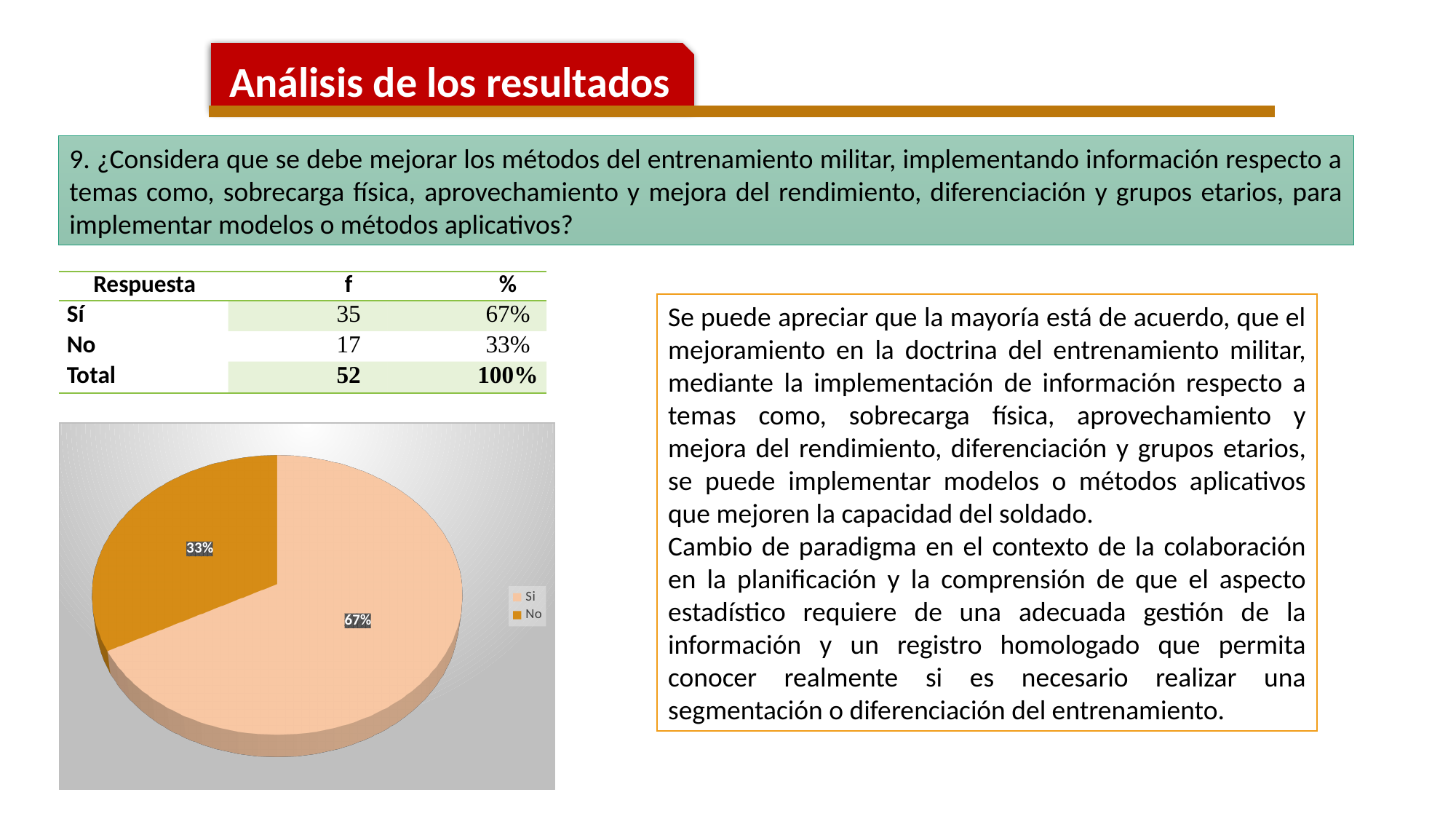
Which slice of the pie chart is the largest? Si What share of the pie does the "No" slice represent? 33% What share of the pie does the "Si" slice represent? 67% What is the difference in percentage points between the "Si" slice and the "No" slice? 34 percentage points What are the two legend entries of the pie chart? Si and No Which slice of the pie chart is the smallest? No How many entries does the legend of the pie chart list? 2 Is the share of the "Si" slice greater or less than 50%? greater Which is larger in the pie chart, the "Si" slice or the "No" slice? Si What kind of chart is shown on the slide? pie chart How many slices does the pie chart have? 2 What colour is the "No" slice in the pie chart? orange